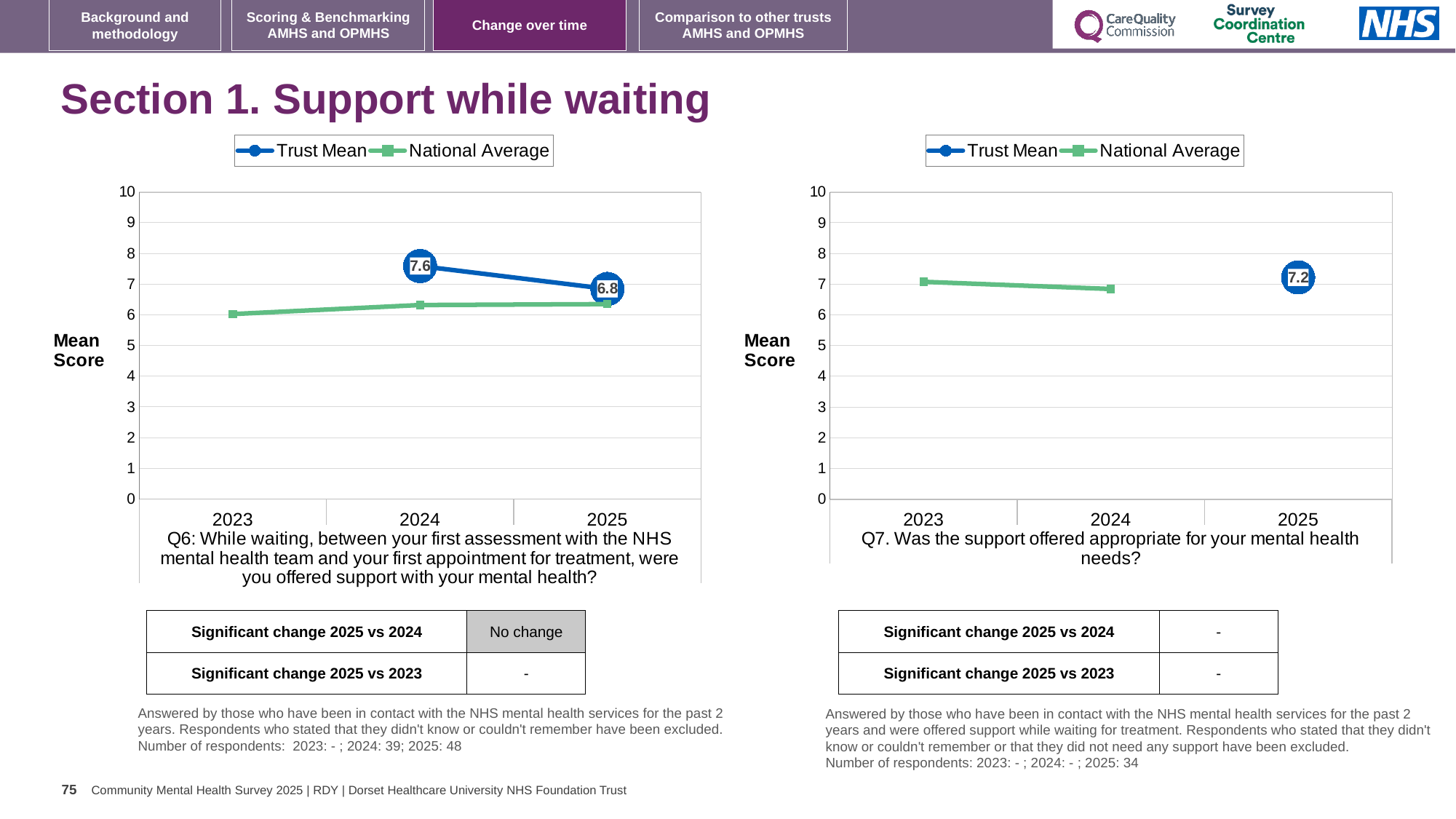
In the Q6 chart on the left, is the National Average for 2023 greater or less than 5? greater How many series does the legend of the Q6 chart on the left list? 2 In the Q6 chart on the left, what is the Trust Mean value for 2025? 6.8 What kind of chart is the Q7 chart on the right? line chart In the Q7 chart on the right, is the National Average for 2024 greater or less than 5? greater What is the label on the y axis of the Q6 chart on the left? Mean Score In the Q6 chart on the left, does the Trust Mean rise or fall from 2024 to 2025? fall In the Q7 chart on the right, what is the Trust Mean value for 2025? 7.2 In the Q6 chart on the left, which is larger in 2025, the Trust Mean or the National Average? Trust Mean How many years are shown on the x axis of the Q7 chart on the right? 3 In the Q6 chart on the left, by how much did the Trust Mean change from 2024 to 2025? 0.8 In the Q6 chart on the left, what is the Trust Mean value for 2024? 7.6